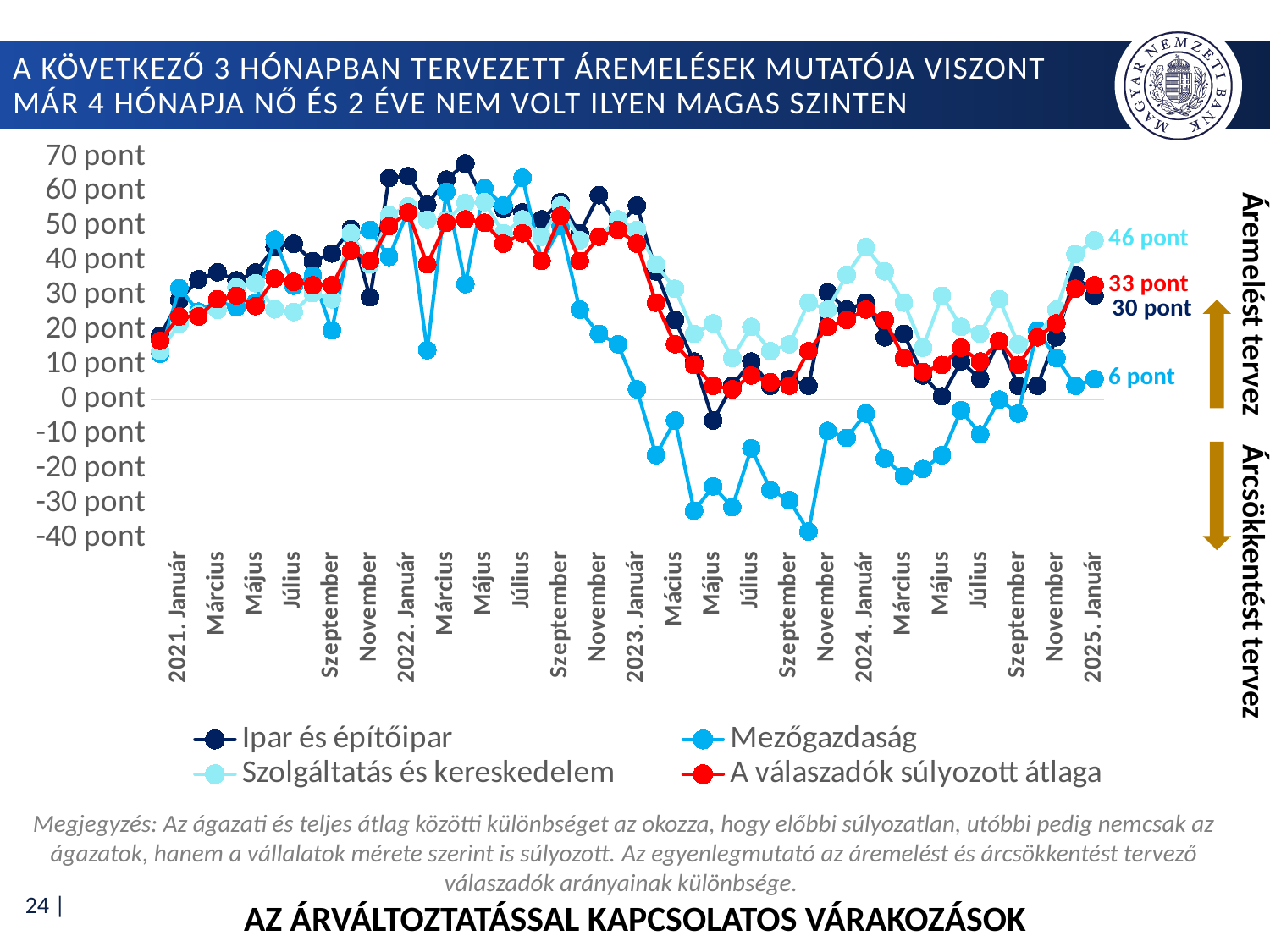
At 2025. Január, which is larger: A válaszadók súlyozott átlaga or Ipar és építőipar? A válaszadók súlyozott átlaga Which series has the highest value at 2025. Január? Szolgáltatás és kereskedelem What kind of chart is shown on the slide? line chart What is the highest value shown on the vertical axis? 70 pont What is the value for Mezőgazdaság at 2025. Január? 6 pont What is the value for Szolgáltatás és kereskedelem at 2025. Január? 46 pont What is the difference between the Szolgáltatás és kereskedelem and Mezőgazdaság values at 2025. Január? 40 pont How many series does the legend list? 4 What is the value for Ipar és építőipar at 2025. Január? 30 pont What is the value for A válaszadók súlyozott átlaga at 2025. Január? 33 pont Is the value for Mezőgazdaság in 2023 Május greater or less than 0 pont? less Which series has the lowest value at 2025. Január? Mezőgazdaság